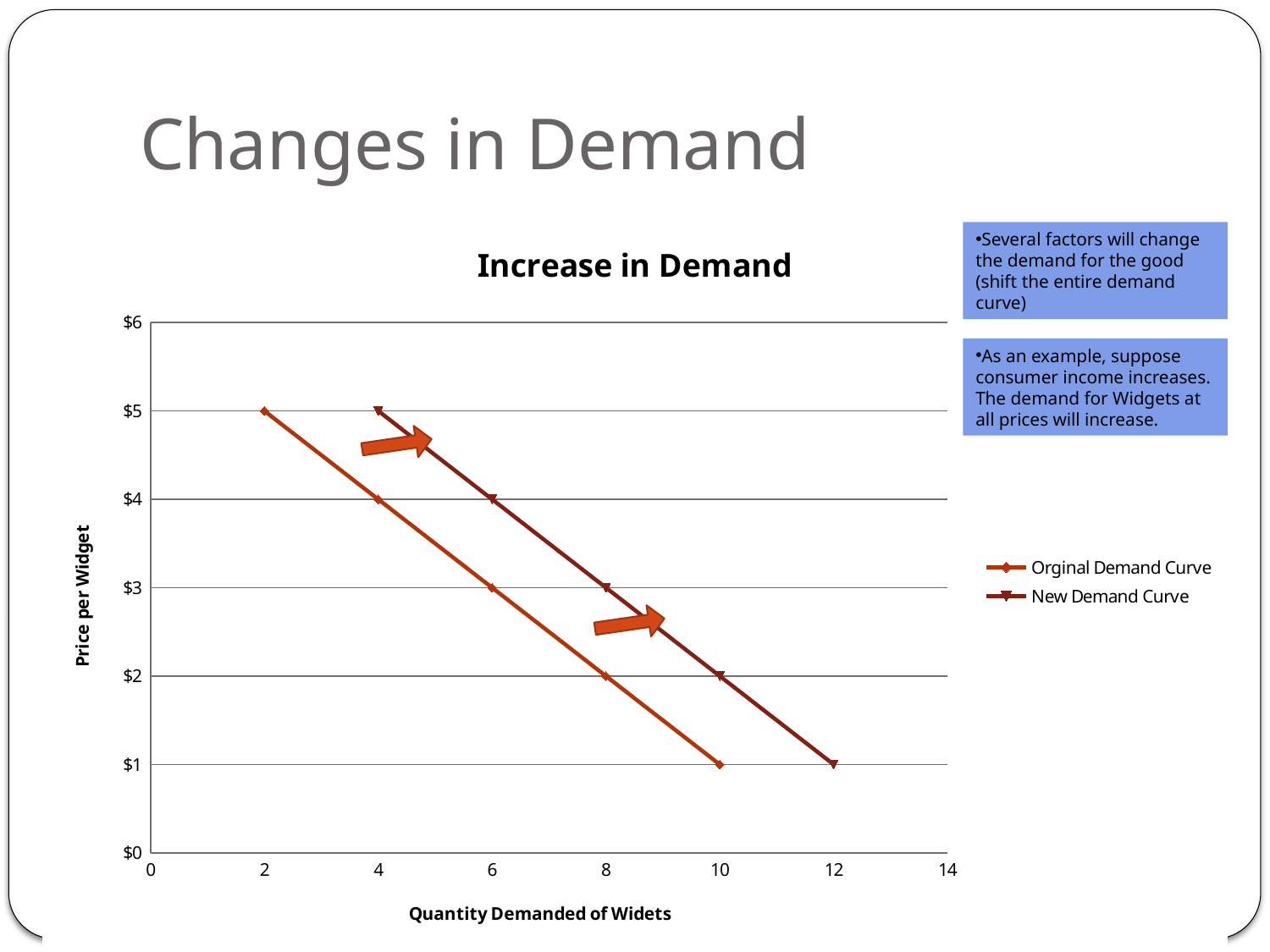
At a price of $5, what quantity is demanded on the New Demand Curve? 4 How many data points are plotted on the Orginal Demand Curve? 5 What is the label of the y axis? Price per Widget At a price of $2, how much larger is the quantity demanded on the New Demand Curve than on the Orginal Demand Curve? 2 What kind of chart is shown? line chart At a price of $5, what quantity is demanded on the Orginal Demand Curve? 2 At a price of $4, which curve shows the larger quantity demanded, the Orginal Demand Curve or the New Demand Curve? New Demand Curve As quantity demanded increases along the x axis, does the price on the Orginal Demand Curve rise or fall? fall At a price of $1, what quantity is demanded on the New Demand Curve? 12 At a price of $3, what quantity is demanded on the Orginal Demand Curve? 6 How many series does the legend list? 2 What is the title of the chart? Increase in Demand